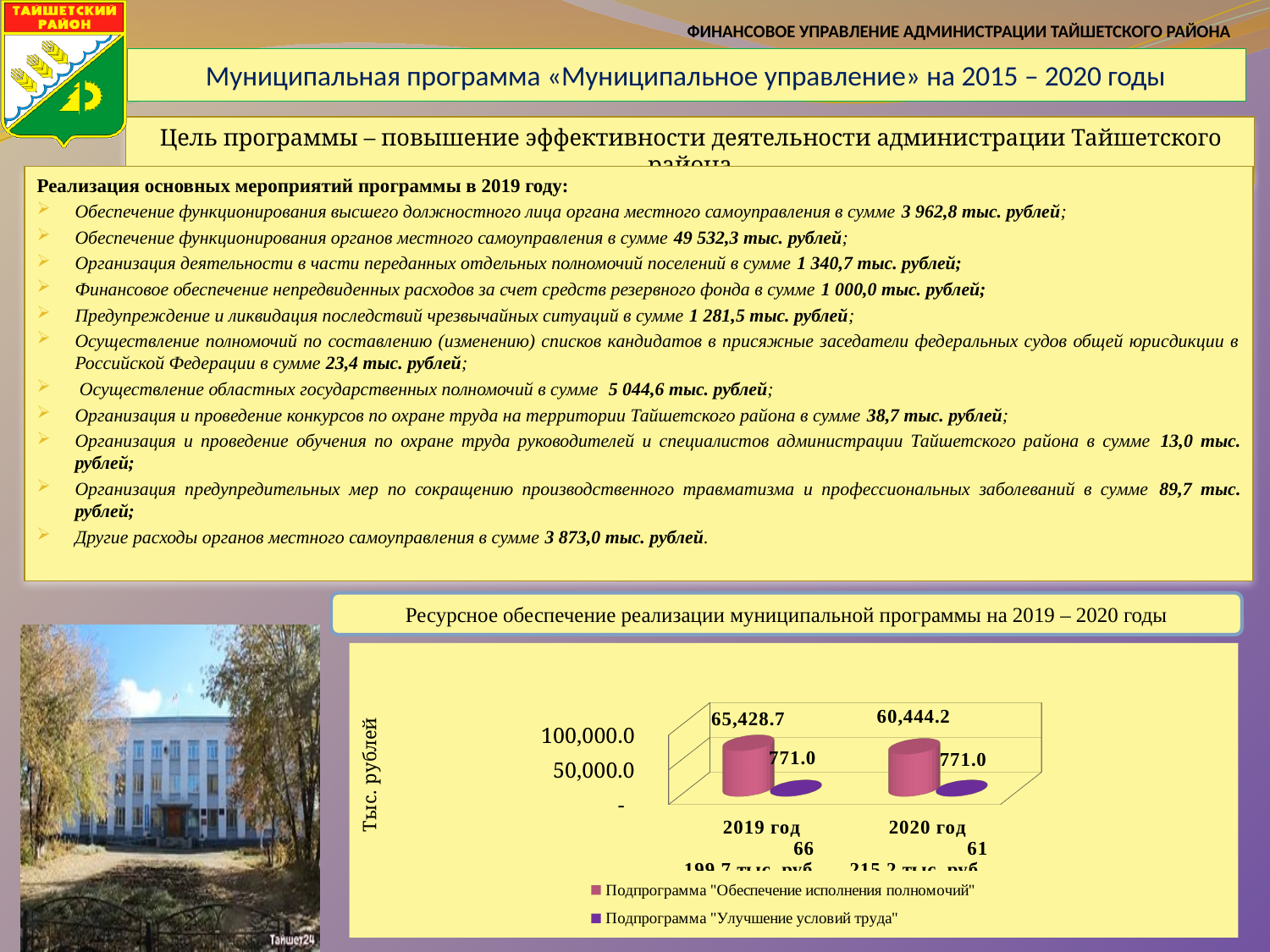
How many series does the chart legend list? 2 By how much does the value for Подпрограмма "Обеспечение исполнения полномочий" in 2019 год exceed its value in 2020 год? 4,984.5 Is the value for Подпрограмма "Обеспечение исполнения полномочий" in 2019 год greater or less than 50,000.0? greater What is the value for Подпрограмма "Обеспечение исполнения полномочий" in 2019 год? 65,428.7 For Подпрограмма "Обеспечение исполнения полномочий", which year has the larger value, 2019 год or 2020 год? 2019 год How many year categories are shown on the x axis of the chart? 2 What is the value for Подпрограмма "Обеспечение исполнения полномочий" in 2020 год? 60,444.2 What kind of chart is shown on the slide? bar chart What is the value for Подпрограмма "Улучшение условий труда" in 2020 год? 771.0 What is the label on the vertical axis of the chart? Тыс. рублей Does the value for Подпрограмма "Обеспечение исполнения полномочий" rise or fall from 2019 год to 2020 год? fall What is the value for Подпрограмма "Улучшение условий труда" in 2019 год? 771.0